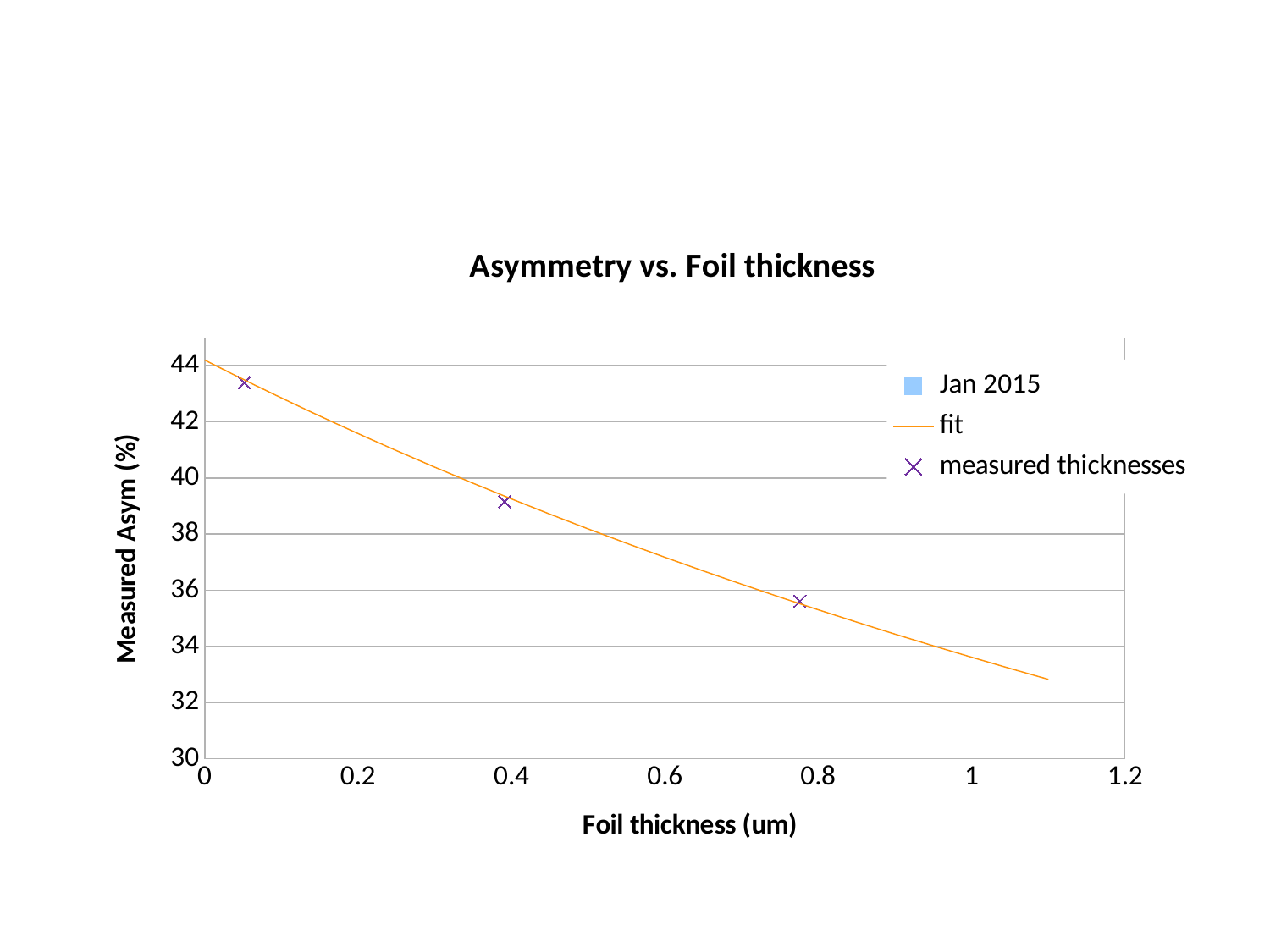
How many entries does the legend list? 3 What is the label of the y axis? Measured Asym (%) Is the measured asymmetry for the foil near 0.8 um greater or less than 34? greater Which measured point has the highest asymmetry: the one near 0.05 um, 0.4 um, or 0.8 um? the one near 0.05 um What is the title of the chart? Asymmetry vs. Foil thickness Is the measured asymmetry for the foil near 0.4 um greater or less than 40? less Does the measured asymmetry rise or fall as foil thickness increases? fall Which measured point has the larger asymmetry, the one near 0.4 um or the one near 0.8 um? the one near 0.4 um Is the measured asymmetry for the thinnest foil (near 0.05 um) greater or less than 42? greater What kind of chart is shown on the slide? scatter chart with a fit line How many measured thickness points are plotted on the chart? 3